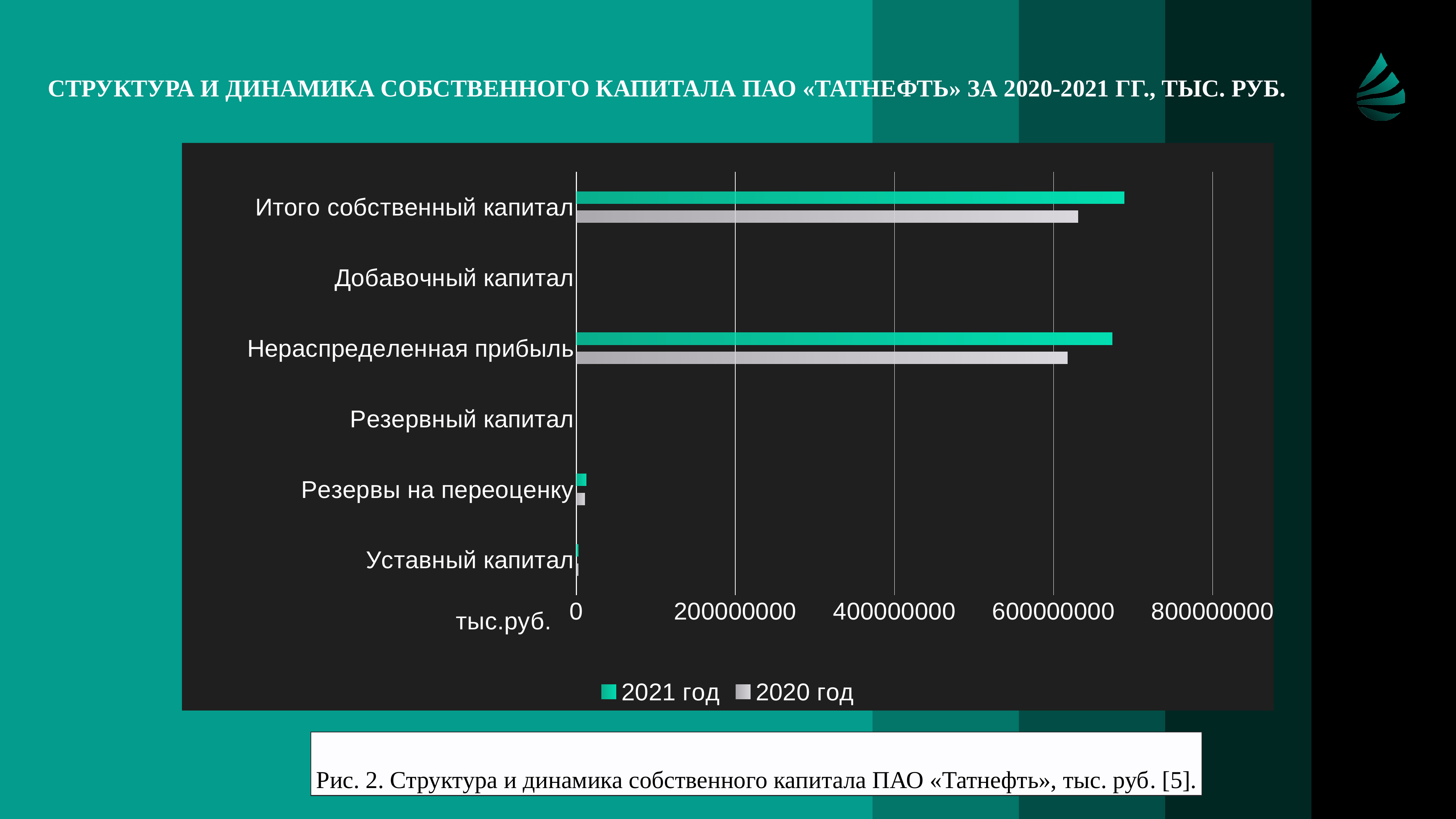
Is the value for Итого собственный капитал in 2020 год greater or less than 400000000? greater For Нераспределенная прибыль, which year has the larger value, 2021 год or 2020 год? 2021 год Which series does the legend list first? 2021 год Is the value for Резервы на переоценку in 2021 год greater or less than 200000000? less What kind of chart is shown on the slide? bar chart Is the value for Нераспределенная прибыль in 2020 год greater or less than 800000000? less How many categories are shown on the vertical axis of the chart? 6 For Итого собственный капитал, which year has the larger value, 2021 год or 2020 год? 2021 год How many series does the legend list? 2 What unit label is shown next to the horizontal axis? тыс.руб.